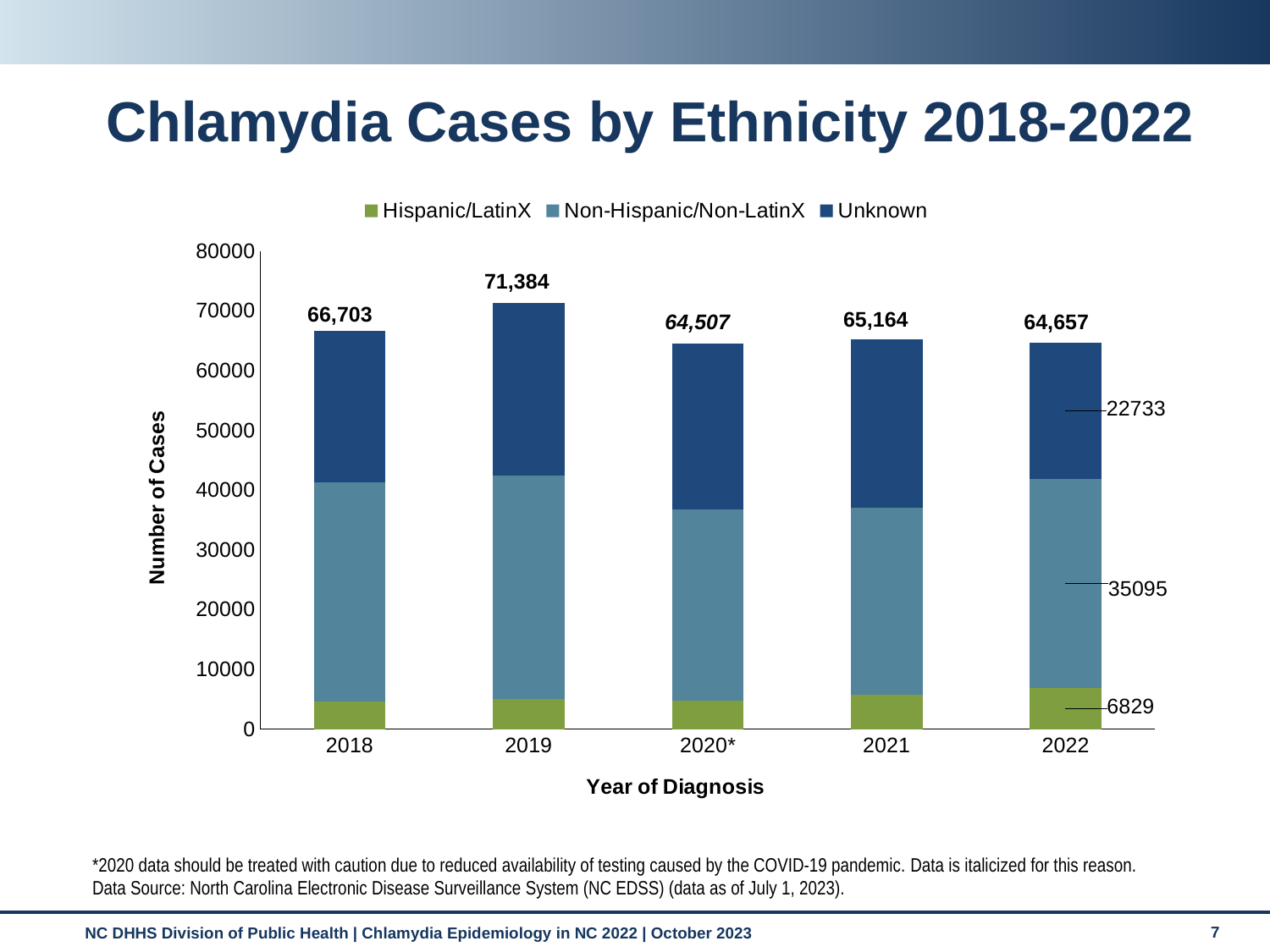
Which year has the lowest total number of chlamydia cases? 2020* How many Non-Hispanic/Non-LatinX chlamydia cases are labeled for 2022? 35095 In 2022, how many more Non-Hispanic/Non-LatinX cases were there than Unknown cases? 12362 How many Hispanic/LatinX chlamydia cases are labeled for 2022? 6829 Which year has the highest total number of chlamydia cases? 2019 What is the difference between the total cases in 2019 and 2018? 4,681 What is the total number of chlamydia cases labeled for 2018? 66,703 How many Unknown-ethnicity chlamydia cases are labeled for 2022? 22733 What kind of chart is shown on the slide? Stacked bar chart What is the total number of chlamydia cases labeled for 2019? 71,384 Is the total number of cases in 2021 greater or less than 70000? less How many series does the legend list? 3